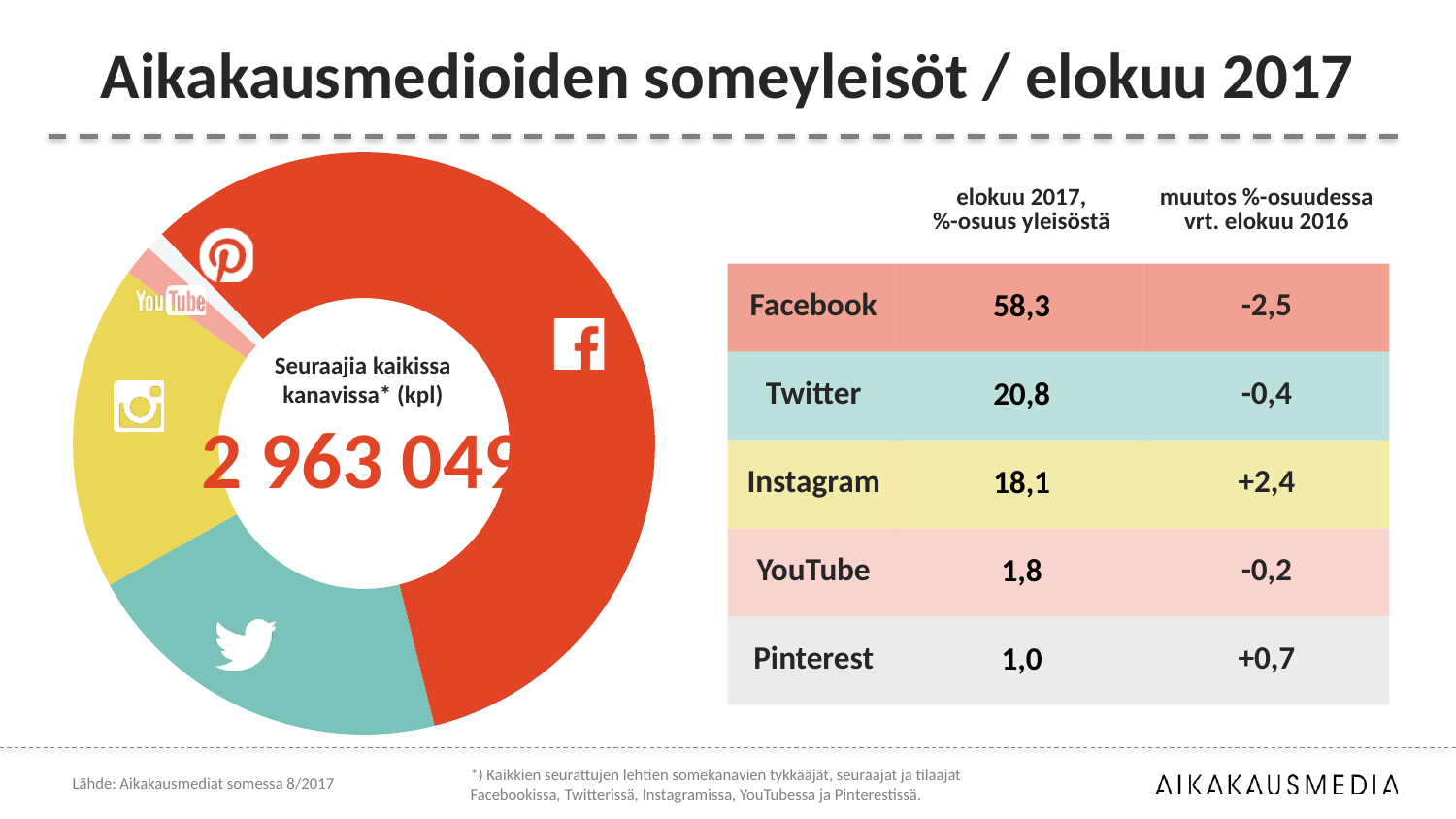
What kind of chart is shown on the left of the slide? Pie (donut) chart What is Instagram's share of the audience in August 2017? 18,1 Which channel has the smallest share of the audience in August 2017? Pinterest What is Facebook's share of the audience in August 2017 (%-osuus yleisöstä)? 58,3 What is the title of the slide? Aikakausmedioiden someyleisöt / elokuu 2017 Which channel has the largest share of the audience in August 2017? Facebook How many social media channels are shown as slices in the donut chart? 5 What is the change in Facebook's share compared with August 2016? -2,5 What is the change in Instagram's share compared with August 2016? +2,4 What is the difference in percentage share between Facebook and Twitter in August 2017? 37,5 Which has a larger share of the audience, Twitter or Instagram? Twitter What is the total number of followers across all channels shown in the centre of the donut chart? 2 963 049